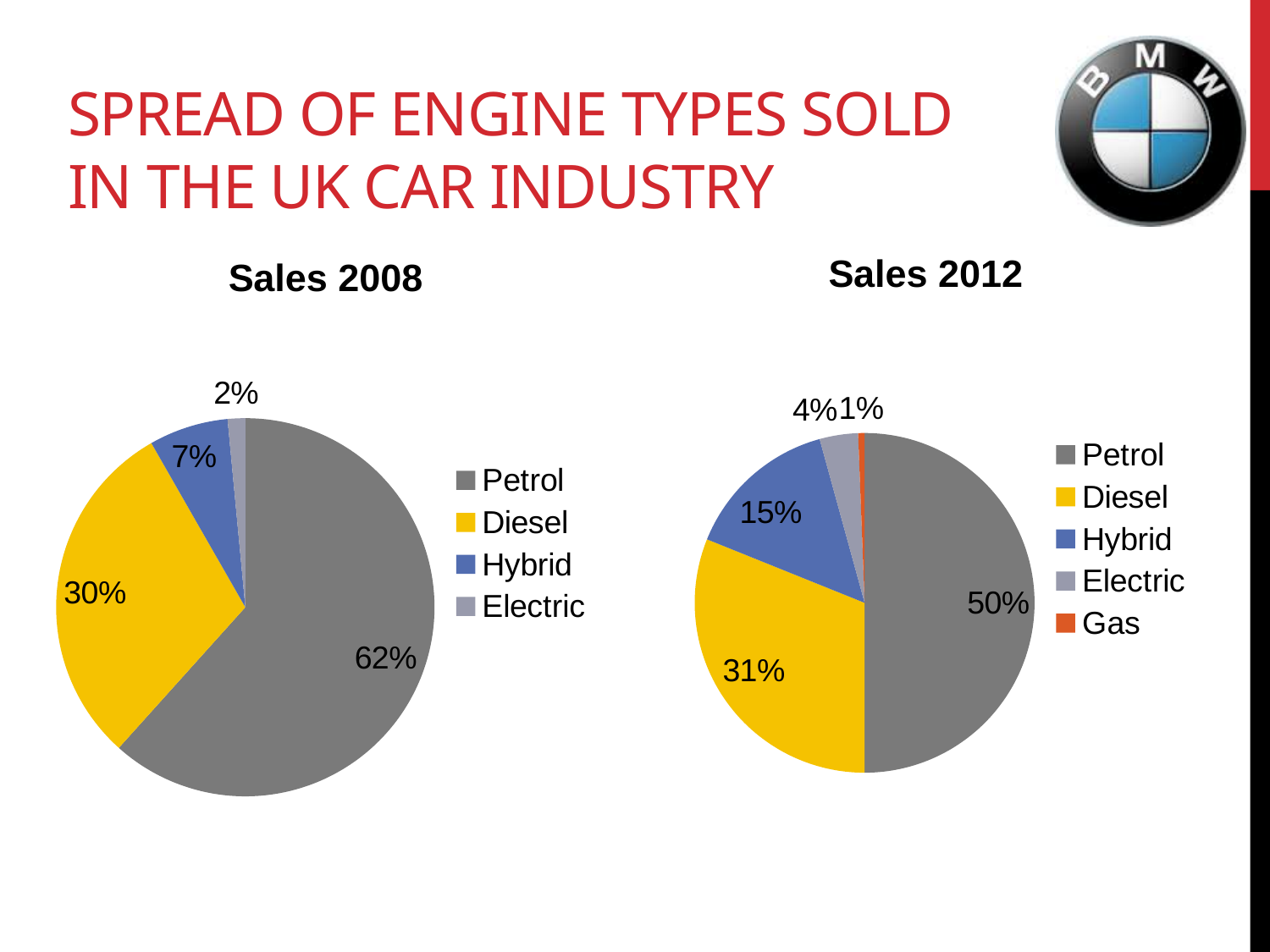
In the Sales 2012 chart, what share of sales is Petrol? 50% How many engine types does the legend of the Sales 2012 chart list? 5 In the Sales 2008 chart, which engine type has the largest share? Petrol Which is larger: the Hybrid share in the Sales 2008 chart or the Hybrid share in the Sales 2012 chart? Sales 2012 In the Sales 2008 chart, what share of sales is Petrol? 62% In the Sales 2012 chart, which engine type has the smallest share? Gas In the Sales 2008 chart, what share of sales is Hybrid? 7% In the Sales 2008 chart, what share of sales is Diesel? 30% In the Sales 2012 chart, what is the difference between the Petrol and Diesel shares? 19% In the Sales 2012 chart, what share of sales is Hybrid? 15% In the Sales 2012 chart, what share of sales is Gas? 1% What kind of chart is the Sales 2008 chart? Pie chart